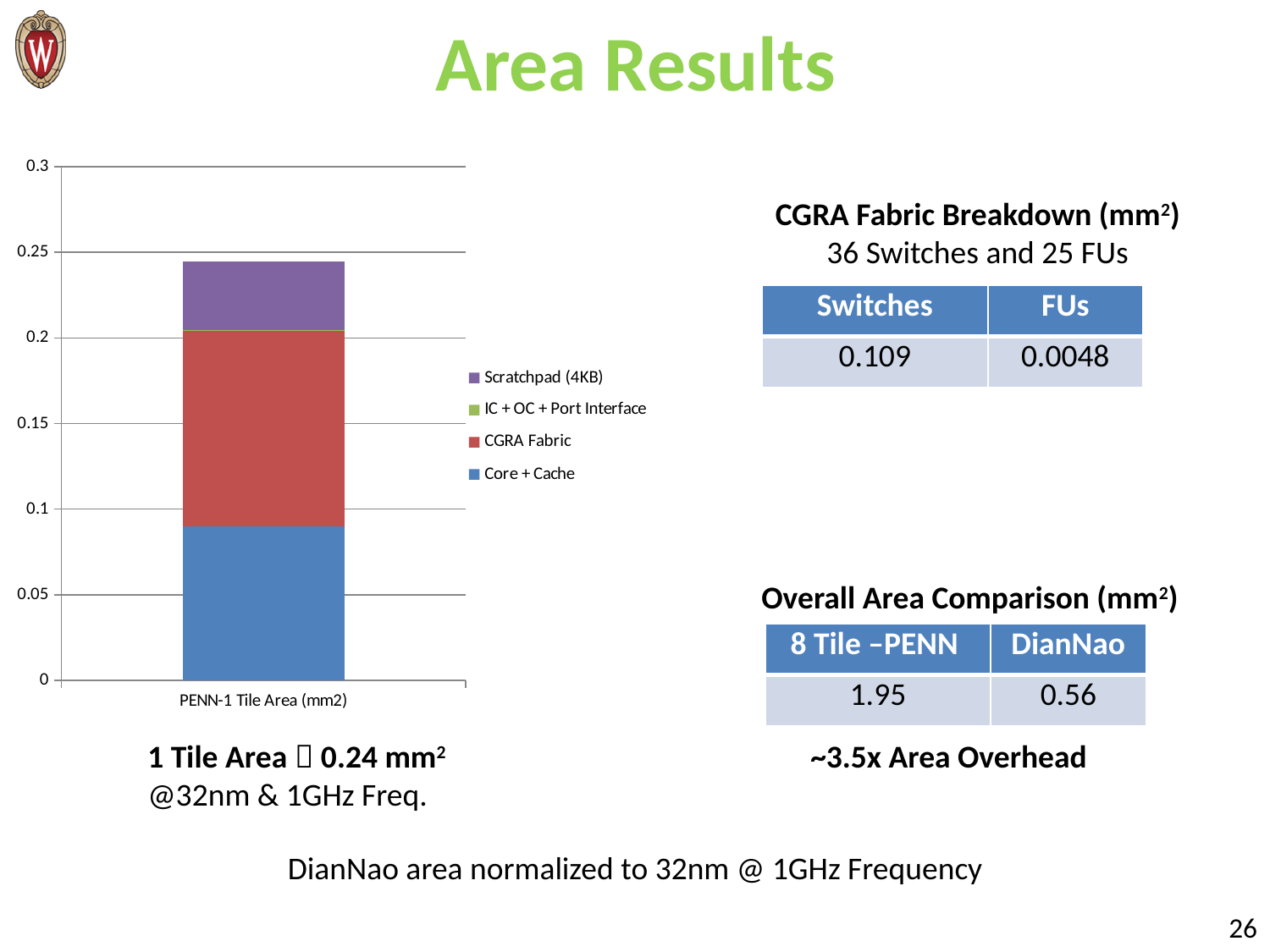
Which series is shown in red in the chart's legend? CGRA Fabric Which series contributes the largest segment to the PENN-1 Tile Area bar? CGRA Fabric Which segment is larger in the stacked bar, CGRA Fabric or Scratchpad (4KB)? CGRA Fabric Which segment is larger in the stacked bar, Core + Cache or Scratchpad (4KB)? Core + Cache Is the total height of the PENN-1 Tile Area stacked bar greater or less than 0.25? less Which series contributes the smallest segment to the PENN-1 Tile Area bar? IC + OC + Port Interface Is the value for Core + Cache greater or less than 0.1? less Is the total height of the PENN-1 Tile Area stacked bar greater or less than 0.2? greater What is the label of the category on the x axis of the chart? PENN-1 Tile Area (mm2) What kind of chart is shown on the slide? stacked bar chart How many series does the chart's legend list? 4 How many categories are plotted on the x axis of the chart? 1